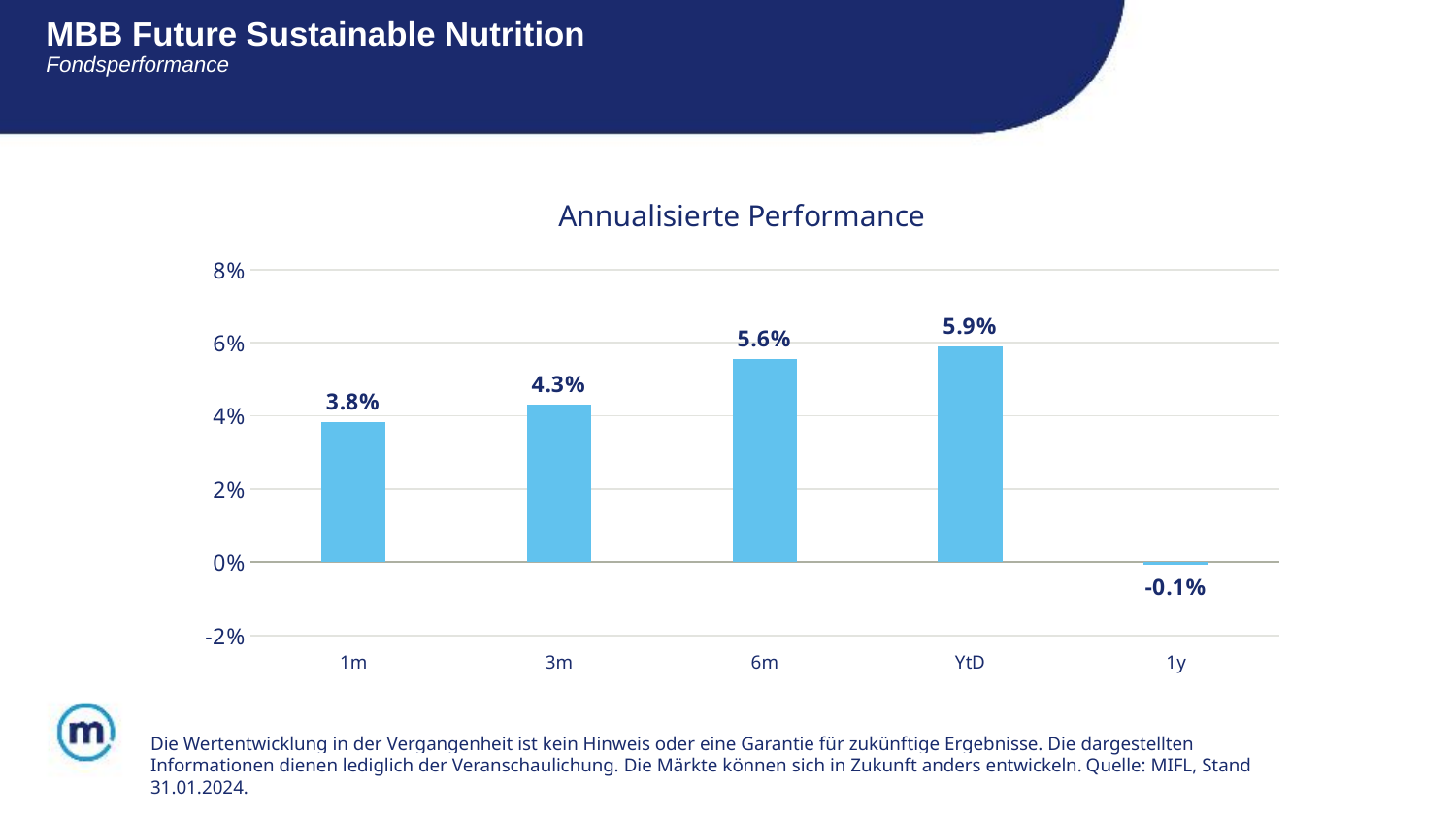
What kind of chart is shown on the slide? Bar chart Which period has the highest annualised performance? YtD What is the annualised performance value for 1m? 3.8% Which period has the lowest annualised performance? 1y What is the annualised performance value for 6m? 5.6% Do the values rise or fall from 1m to YtD? Rise What is the title of the chart? Annualisierte Performance What is the difference between the YtD value and the 1m value? 2.1% Which is larger, the value for 3m or the value for 6m? 6m What is the annualised performance value for 1y? -0.1% Is the value for 3m greater or less than 4%? greater How many periods are shown on the x axis? 5